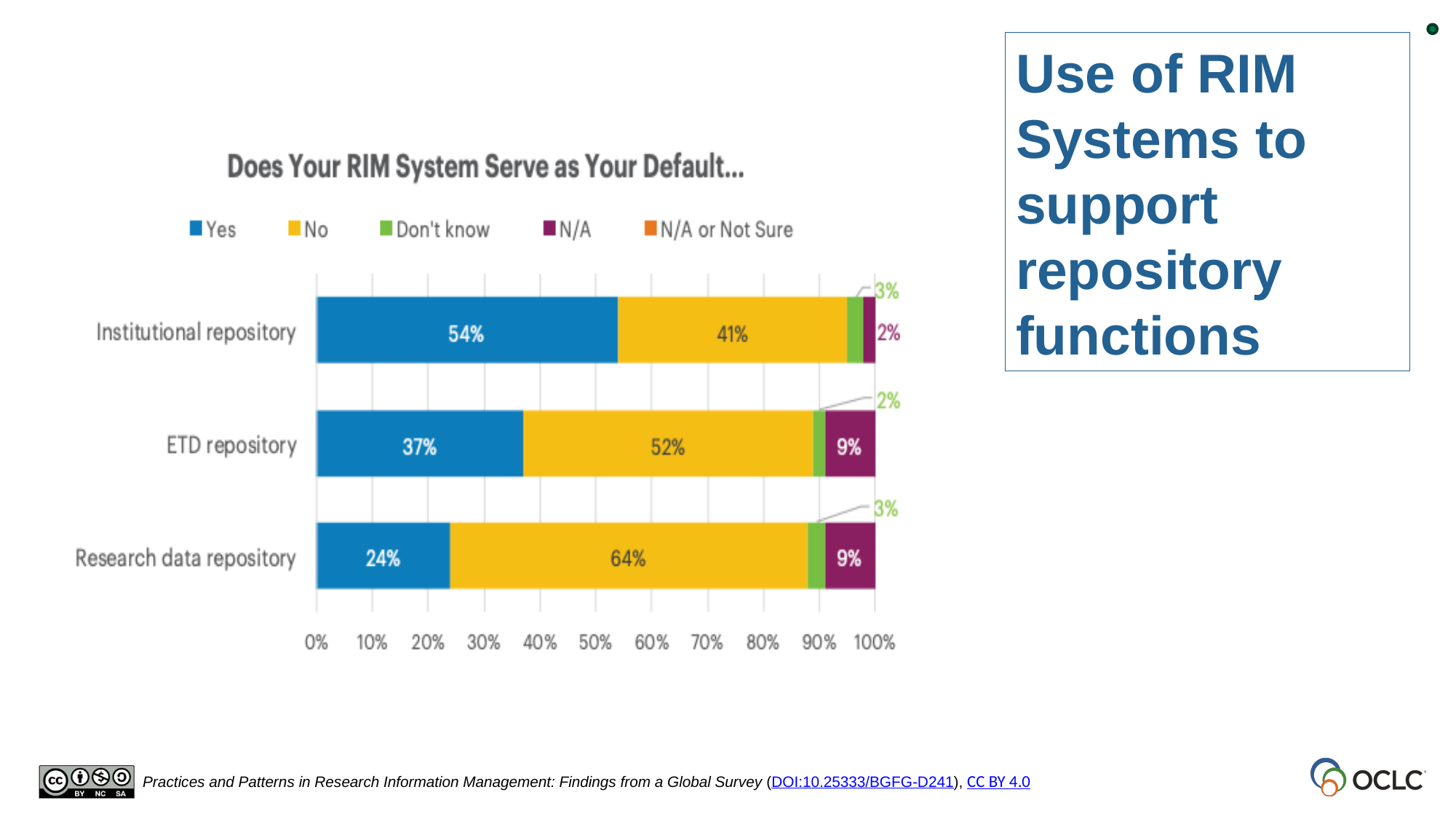
Which repository type has the highest "Yes" percentage? Institutional repository Which is larger: the "Yes" value for ETD repository or the "Yes" value for Research data repository? ETD repository What is the title of the chart? Does Your RIM System Serve as Your Default... What percentage of respondents answered "No" for Research data repository? 64% How many repository categories are shown in the chart? 3 What is the "N/A" value for ETD repository? 9% What percentage of respondents answered "Yes" for Institutional repository? 54% Which repository type has the lowest "Yes" percentage? Research data repository How many series does the legend list? 5 What is the difference between the "No" percentages for Research data repository and Institutional repository? 23% What is the "Don't know" value for Institutional repository? 3% What kind of chart is shown on the slide? Stacked bar chart